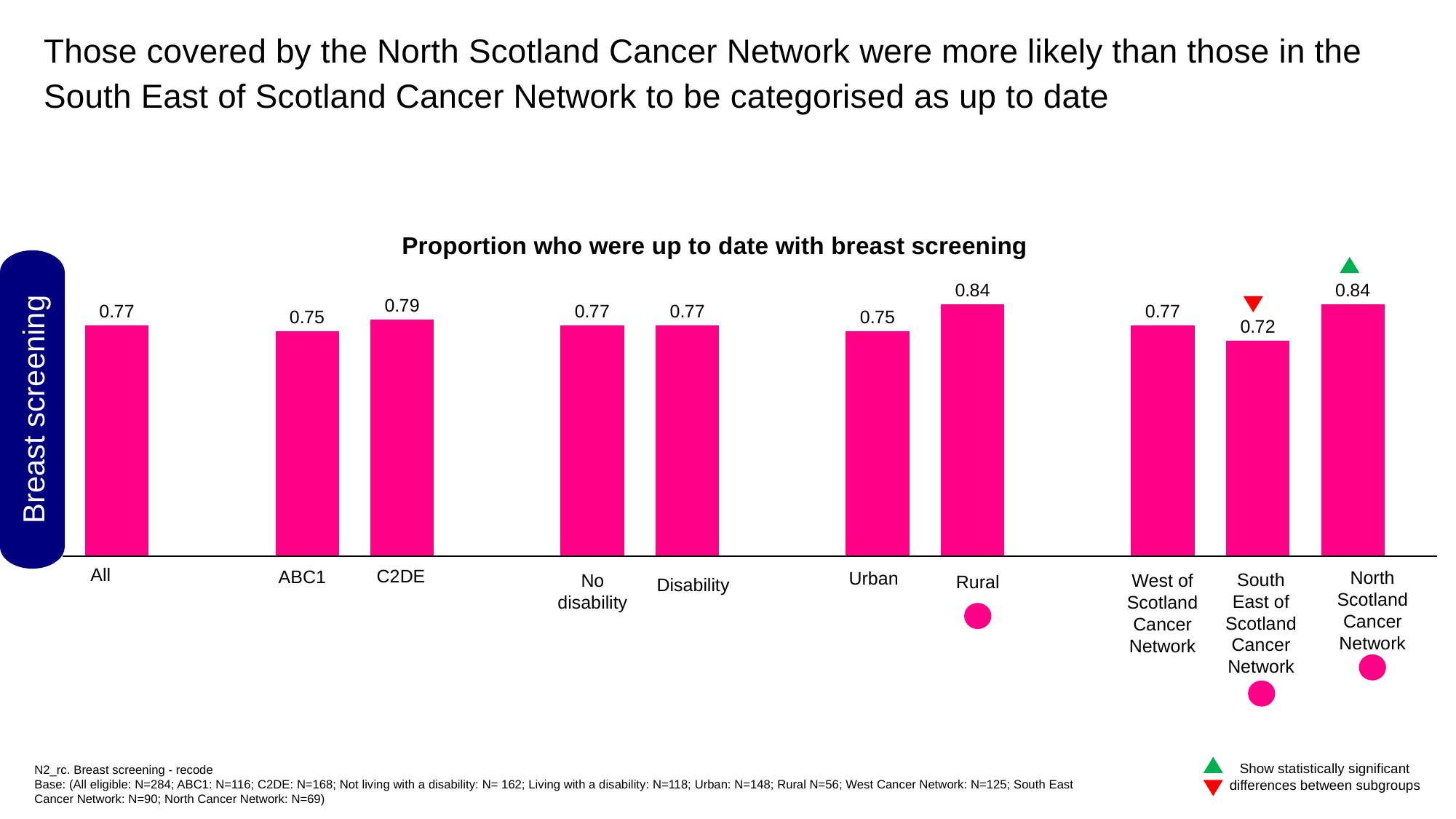
What is the value shown for the North Scotland Cancer Network? 0.84 How many categories are plotted in the chart? 10 Which category has the lowest proportion up to date with breast screening? South East of Scotland Cancer Network What is the difference between the values for the North Scotland Cancer Network and the South East of Scotland Cancer Network? 0.12 What type of chart is shown on the slide? Bar chart What is the difference between the values for Rural and Urban? 0.09 What is the title of the chart? Proportion who were up to date with breast screening What is the value shown for Rural? 0.84 Which has the larger value, ABC1 or C2DE? C2DE What is the value shown for the South East of Scotland Cancer Network? 0.72 What is the value for All in the chart? 0.77 What proportion of the C2DE group were up to date with breast screening? 0.79